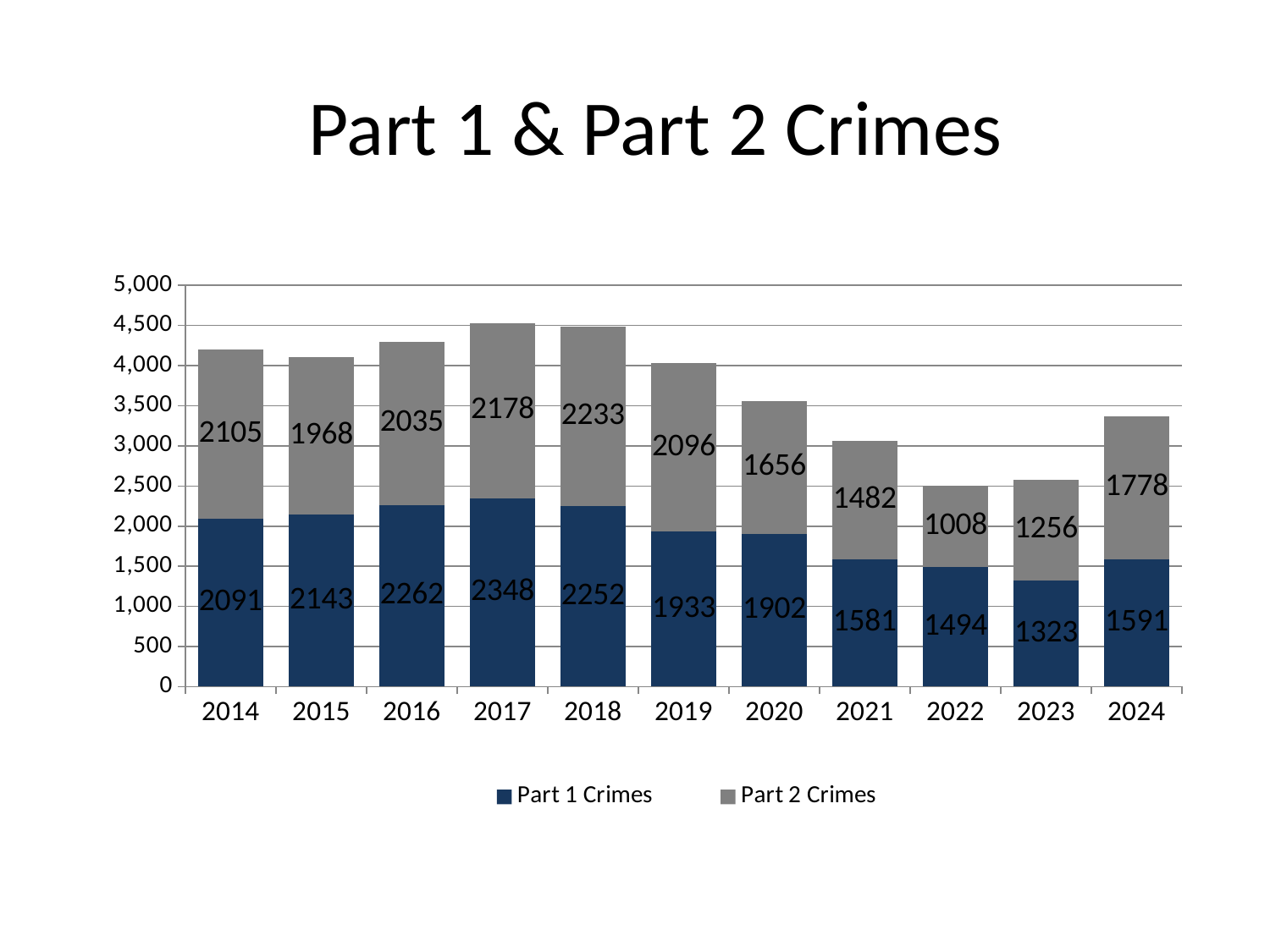
What is the difference between Part 1 Crimes in 2017 and Part 1 Crimes in 2023? 1025 What is the value for Part 1 Crimes in 2017? 2348 What kind of chart is shown on the slide? Stacked bar chart In 2024, which is larger: Part 1 Crimes or Part 2 Crimes? Part 2 Crimes How many years are shown on the x axis? 11 What is the total of the stacked bar for 2022? 2502 Which year has the lowest value for Part 2 Crimes? 2022 What is the value for Part 2 Crimes in 2022? 1008 Which year has the lowest value for Part 1 Crimes? 2023 Which year has the highest value for Part 1 Crimes? 2017 Do the Part 1 Crimes values rise or fall from 2018 to 2023? Fall How many series does the legend list? 2